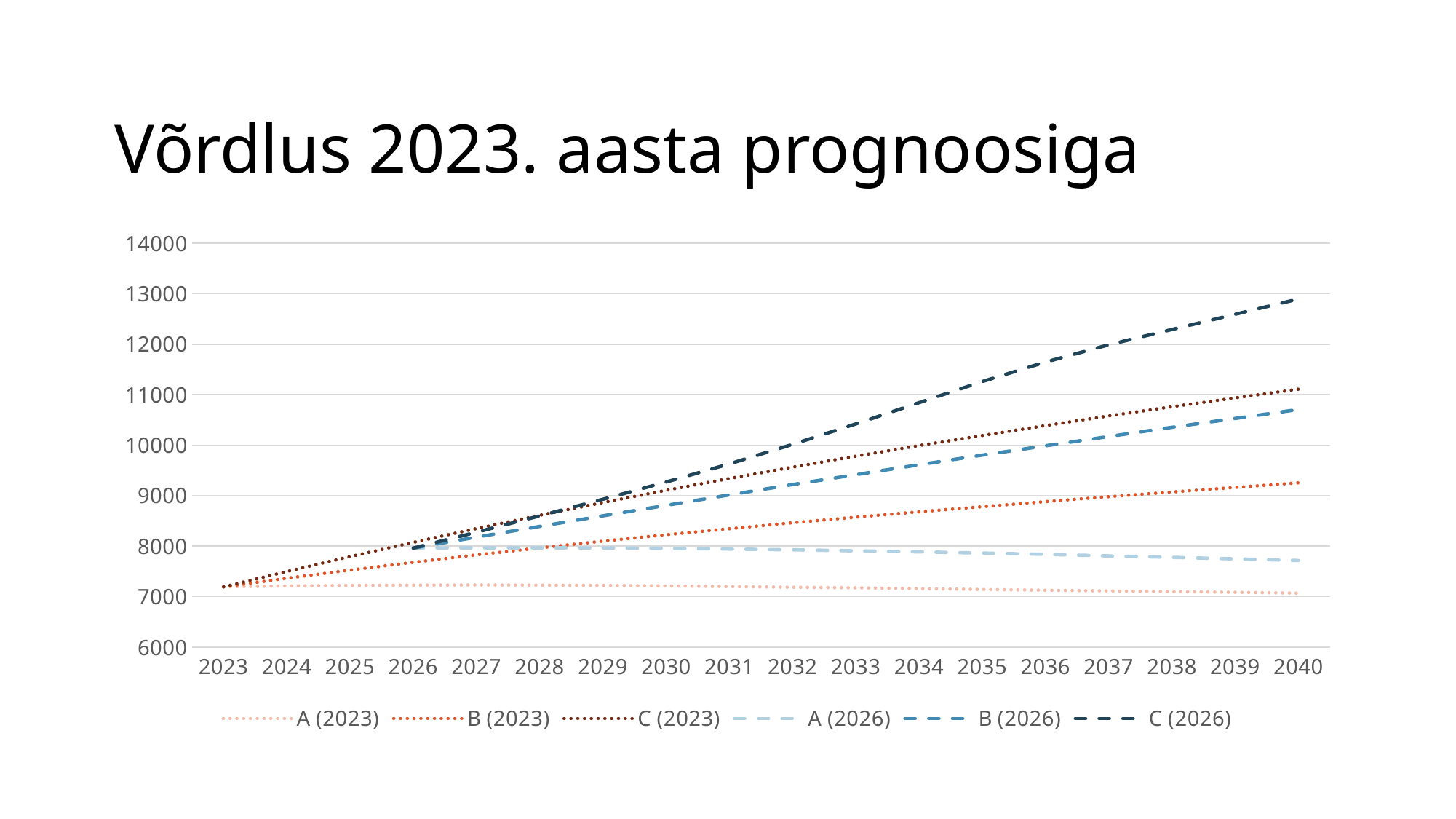
Is the value for A (2023) in 2040 greater or less than 8000? less Which series has the lowest value in 2040? A (2023) Is the value for C (2026) in 2040 greater or less than 12000? greater Is the value for B (2023) in 2040 greater or less than 9000? greater How many series does the legend list? 6 What kind of chart is shown on the slide? line chart What is the title of the chart? Võrdlus 2023. aasta prognoosiga In which year do the A (2026), B (2026) and C (2026) series begin? 2026 Does the C (2026) series rise or fall from 2026 to 2040? rise How many years are shown on the x axis? 18 In 2040, which is larger: B (2026) or B (2023)? B (2026) Which series has the highest value in 2040? C (2026)